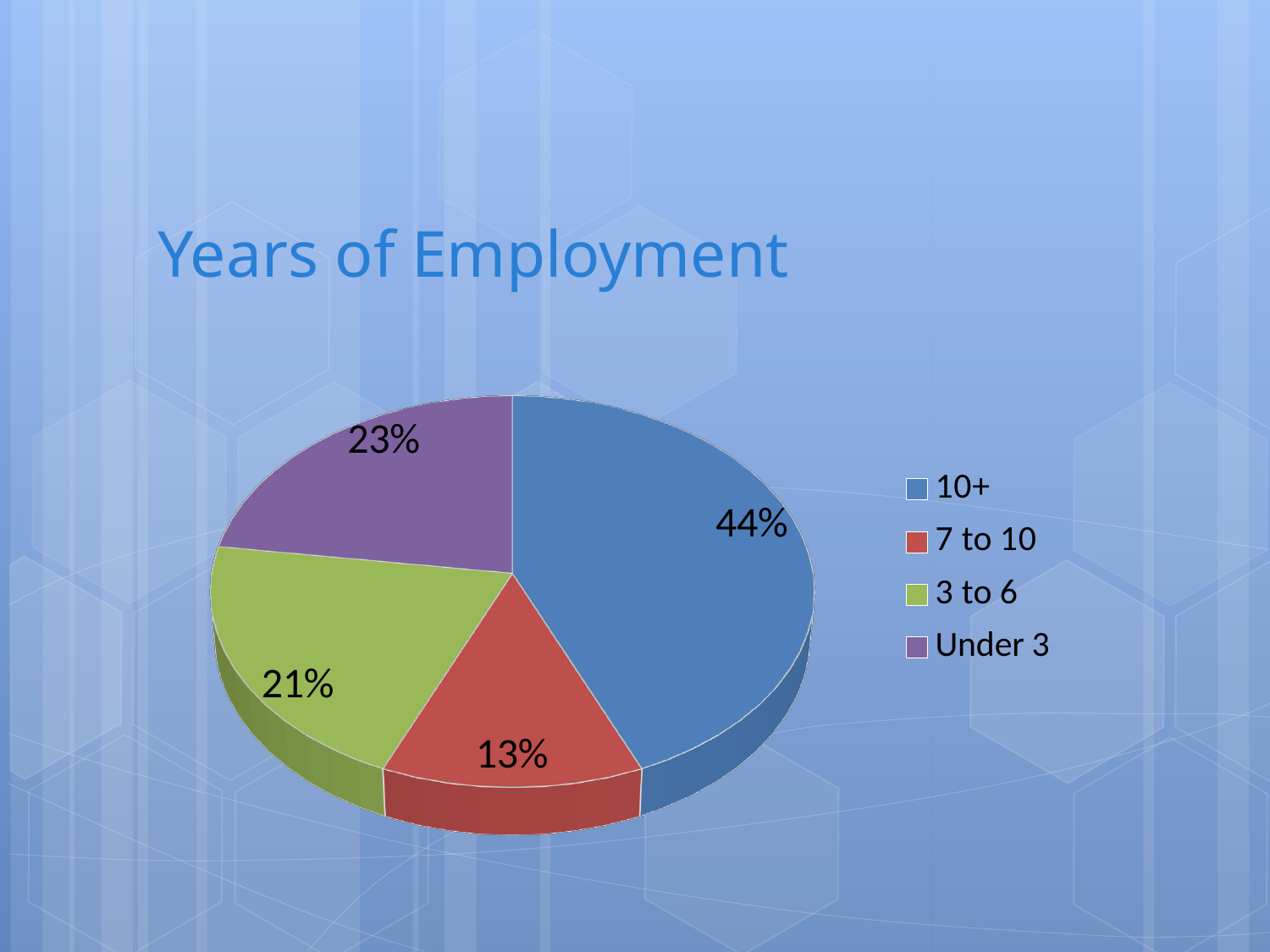
Which category has the largest slice of the pie? 10+ What share of the pie does the 10+ category have? 44% What is the difference in percentage points between the 10+ slice and the 7 to 10 slice? 31 What percentage is shown for the 3 to 6 category? 21% How many categories does the pie chart show? 4 What kind of chart is shown on the slide? Pie chart What percentage is shown for the 7 to 10 category? 13% Which is larger, the Under 3 slice or the 3 to 6 slice? Under 3 Which category has the smallest slice of the pie? 7 to 10 What percentage is shown for the Under 3 category? 23% What colour is the slice for the 3 to 6 category? Green What is the title of the slide? Years of Employment